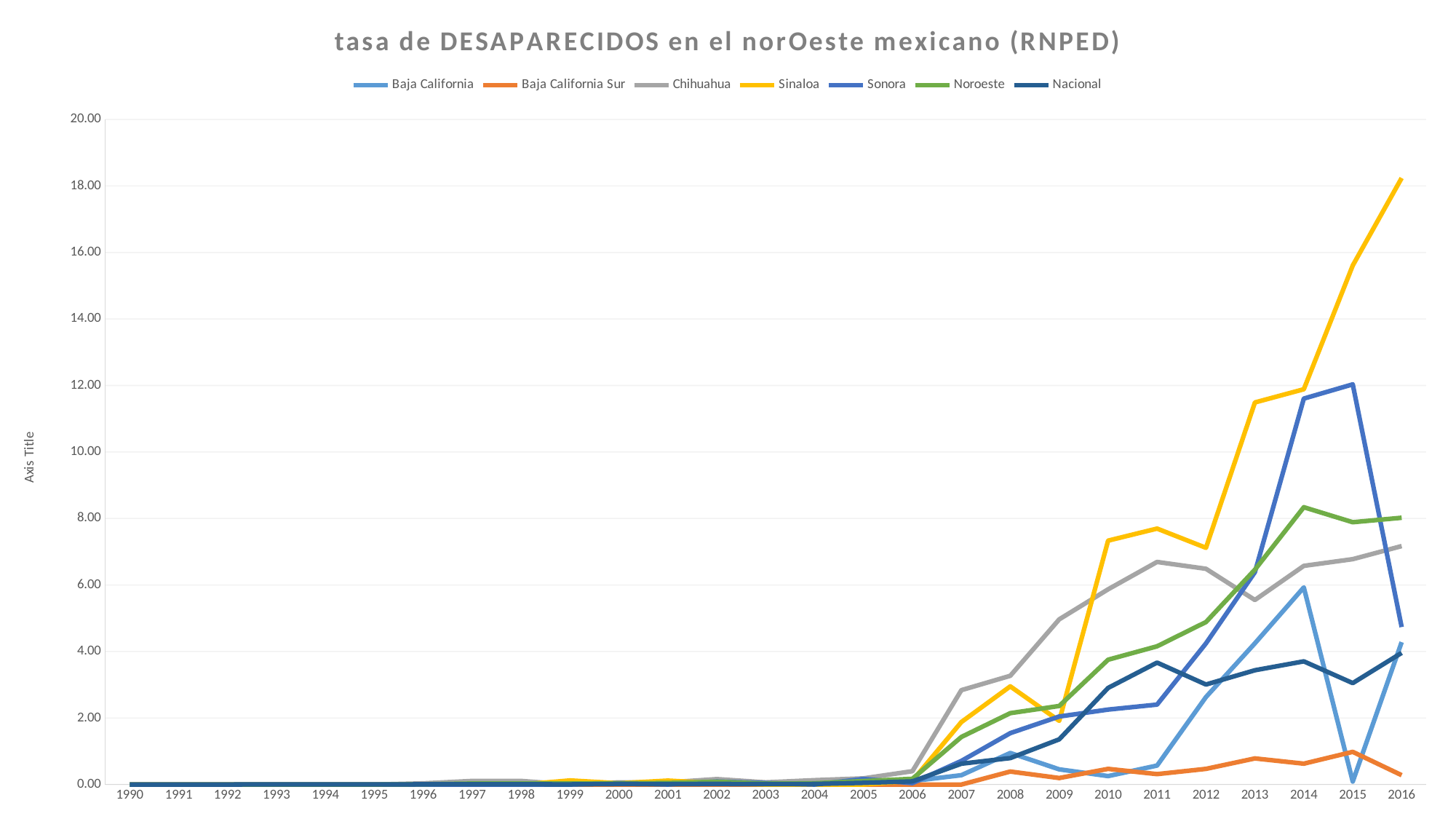
Is the value for Sonora in 2014 greater or less than 10.00? greater In 2014, which is larger: the value for Noroeste or the value for Nacional? Noroeste Which series has the lowest value in 2016? Baja California Sur Does the Sinaloa line rise or fall from 2012 to 2016? rises Which series has the highest value in 2016? Sinaloa What is the title of the chart? tasa de DESAPARECIDOS en el norOeste mexicano (RNPED) What kind of chart is shown on the slide? Line chart Is the value for Baja California Sur in 2016 greater or less than 2.00? less Is the value for Sinaloa in 2016 greater or less than 16.00? greater How many years are shown along the x axis? 27 In 2015, which is larger: the value for Sonora or the value for Chihuahua? Sonora How many series does the legend list? 7